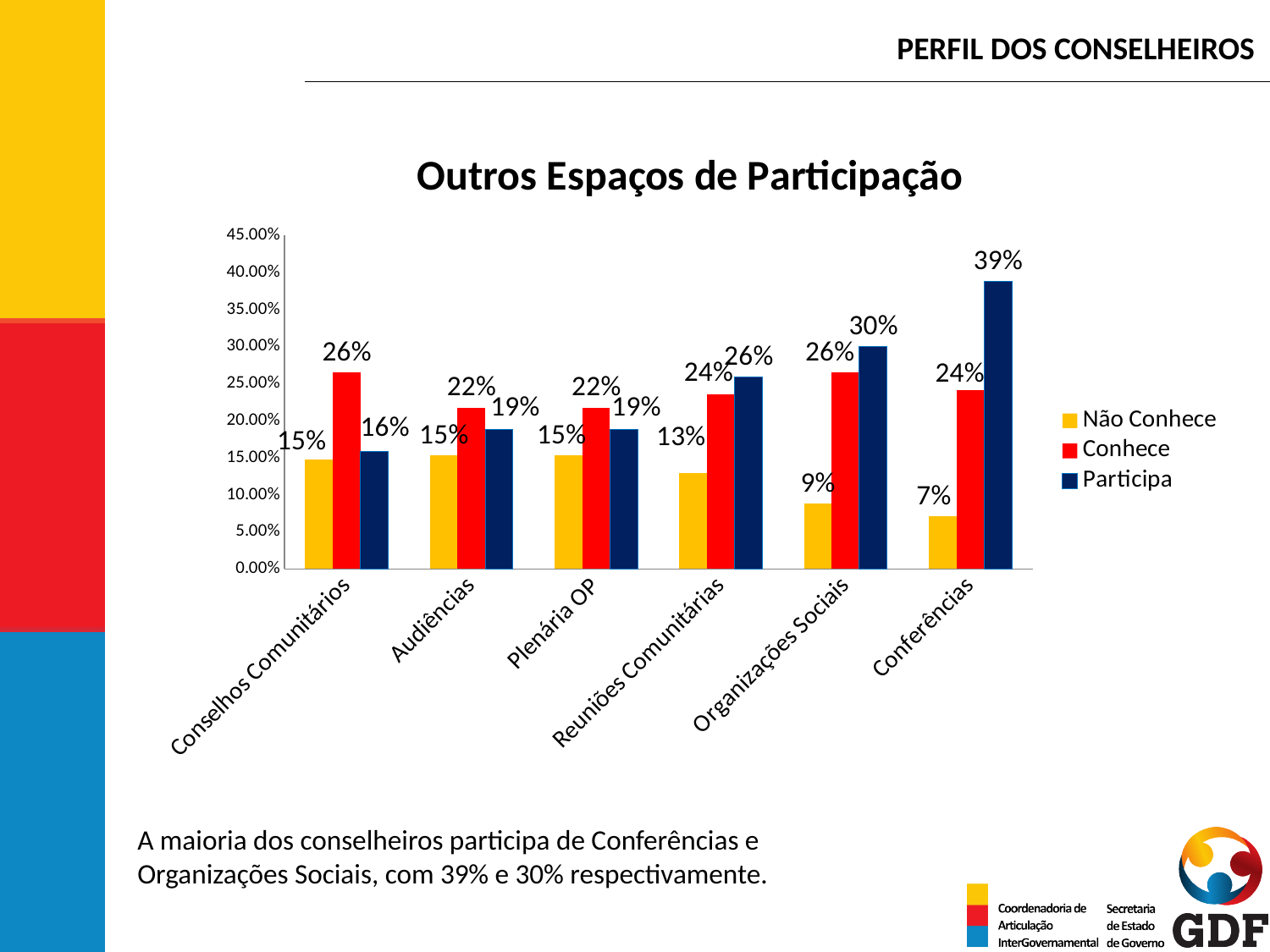
How many series does the legend list? 3 What is the Não Conhece value for Organizações Sociais? 9% What is the Conhece value for Reuniões Comunitárias? 24% What is the title of the chart? Outros Espaços de Participação What kind of chart is shown on the slide? Bar chart Which category has the highest Participa value? Conferências How many categories are shown on the x axis? 6 What is the Participa value for Conferências? 39% Which is larger for Conselhos Comunitários: the Conhece value or the Participa value? Conhece Is the Participa value for Conferências greater or less than 35.00%? greater Which category has the lowest Não Conhece value? Conferências What is the difference between the Participa value for Conferências and the Participa value for Organizações Sociais? 9%